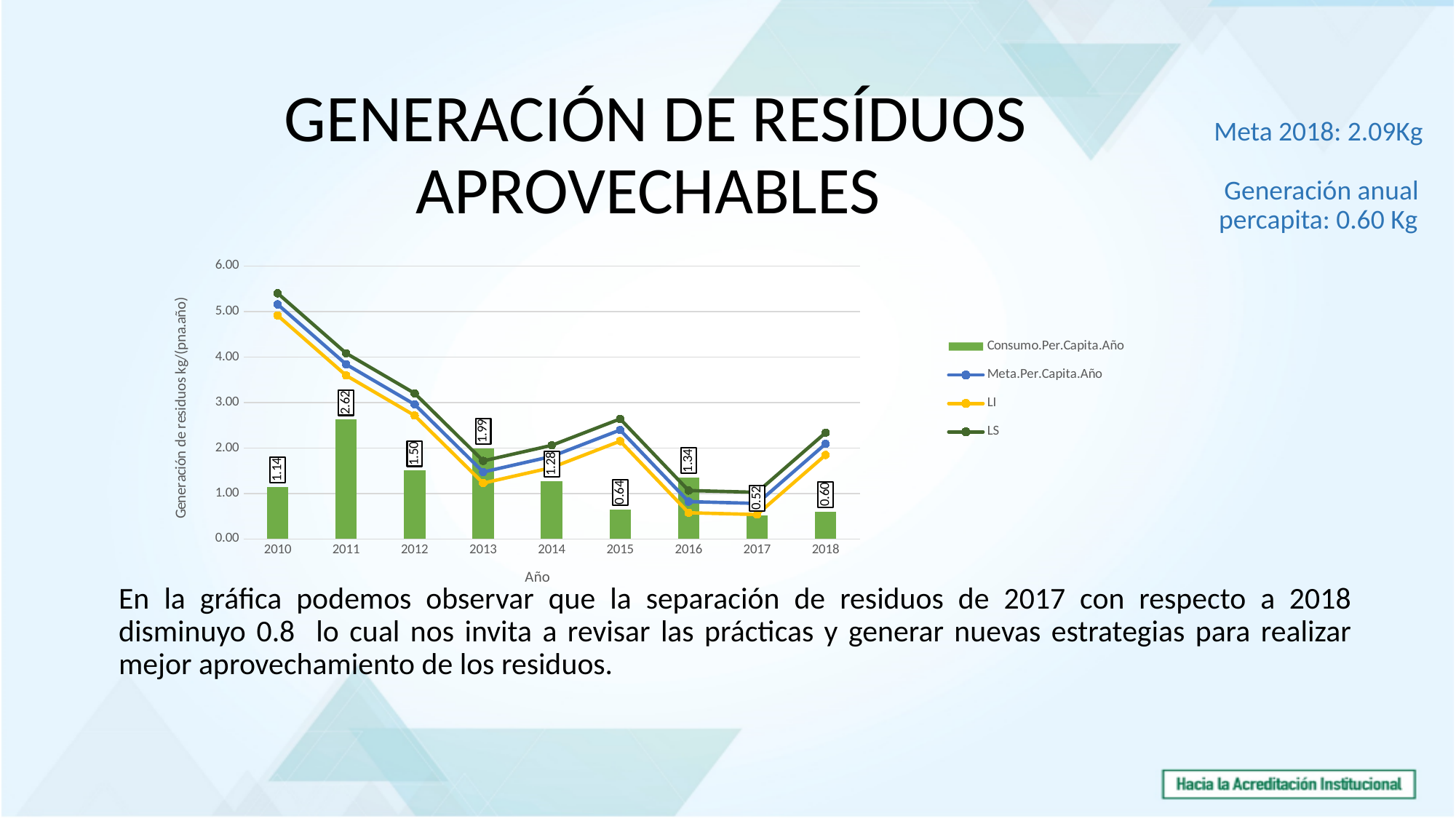
Is the LI value for 2017 greater or less than 1.00? less What is the Consumo.Per.Capita.Año value for 2011? 2.62 What is the Consumo.Per.Capita.Año value for 2018? 0.60 How many years are shown on the x axis? 9 How many series does the legend list? 4 Which year has the lowest Consumo.Per.Capita.Año bar? 2017 What is the difference between the Consumo.Per.Capita.Año values for 2011 and 2012? 1.12 What kind of chart is shown on the slide? Combined bar and line chart Is the LS value for 2010 greater or less than 5.00? greater Which is larger, the Consumo.Per.Capita.Año value for 2013 or for 2016? 2013 What is the Consumo.Per.Capita.Año value for 2014? 1.28 Which year has the highest Consumo.Per.Capita.Año bar? 2011